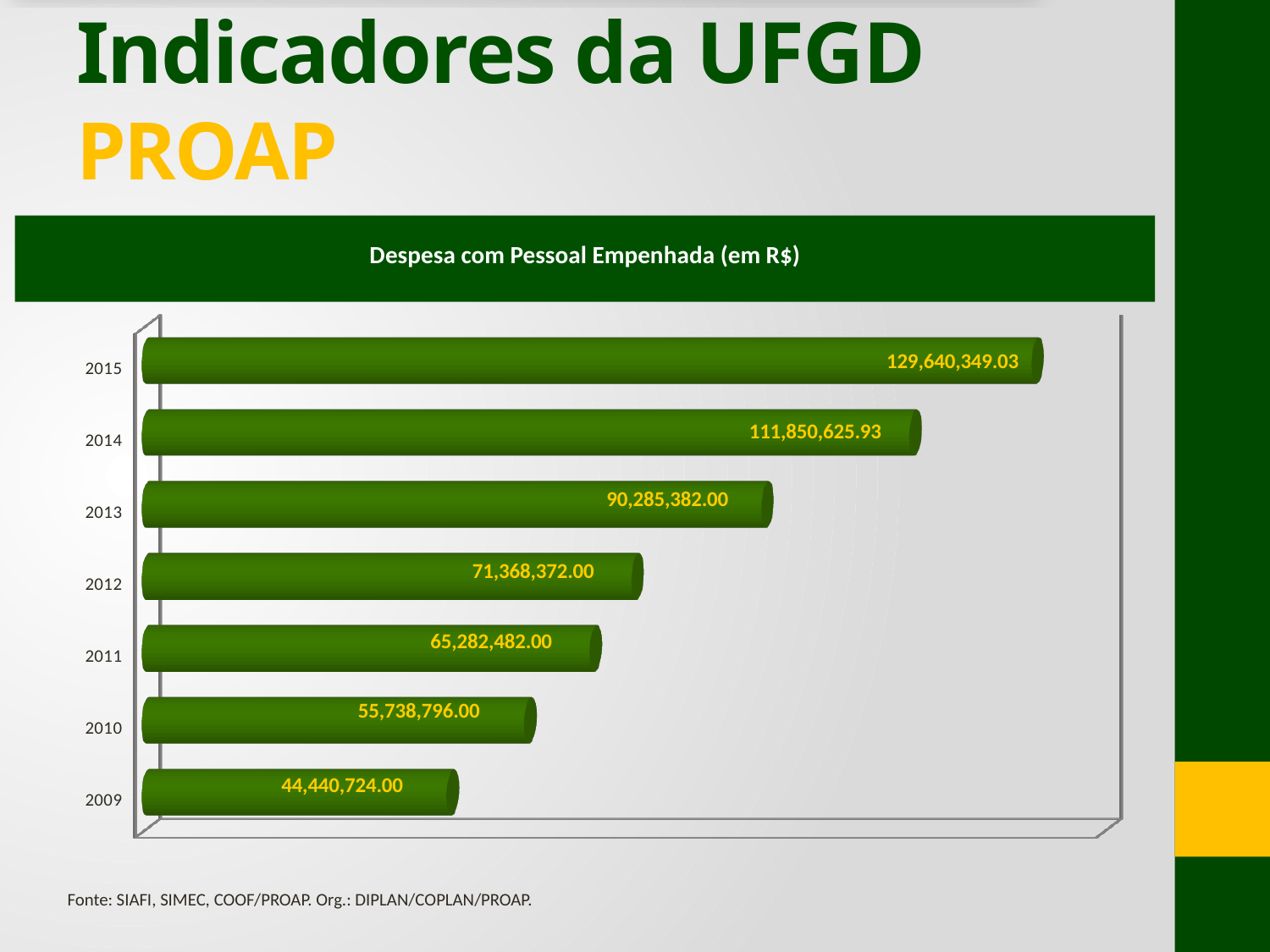
What is the value for 2009? 44,440,724.00 What is the difference between the values for 2013 and 2012? 18,917,010.00 Which year has the lowest value? 2009 Do the values rise or fall from 2009 to 2015? rise What kind of chart is shown? bar chart Which is larger, the value for 2011 or the value for 2013? 2013 How many years are shown in the chart? 7 Which year has the highest value? 2015 What is the value for 2010? 55,738,796.00 What is the value for 2012? 71,368,372.00 What is the difference between the values for 2015 and 2014? 17,789,723.10 What is the value for 2015? 129,640,349.03